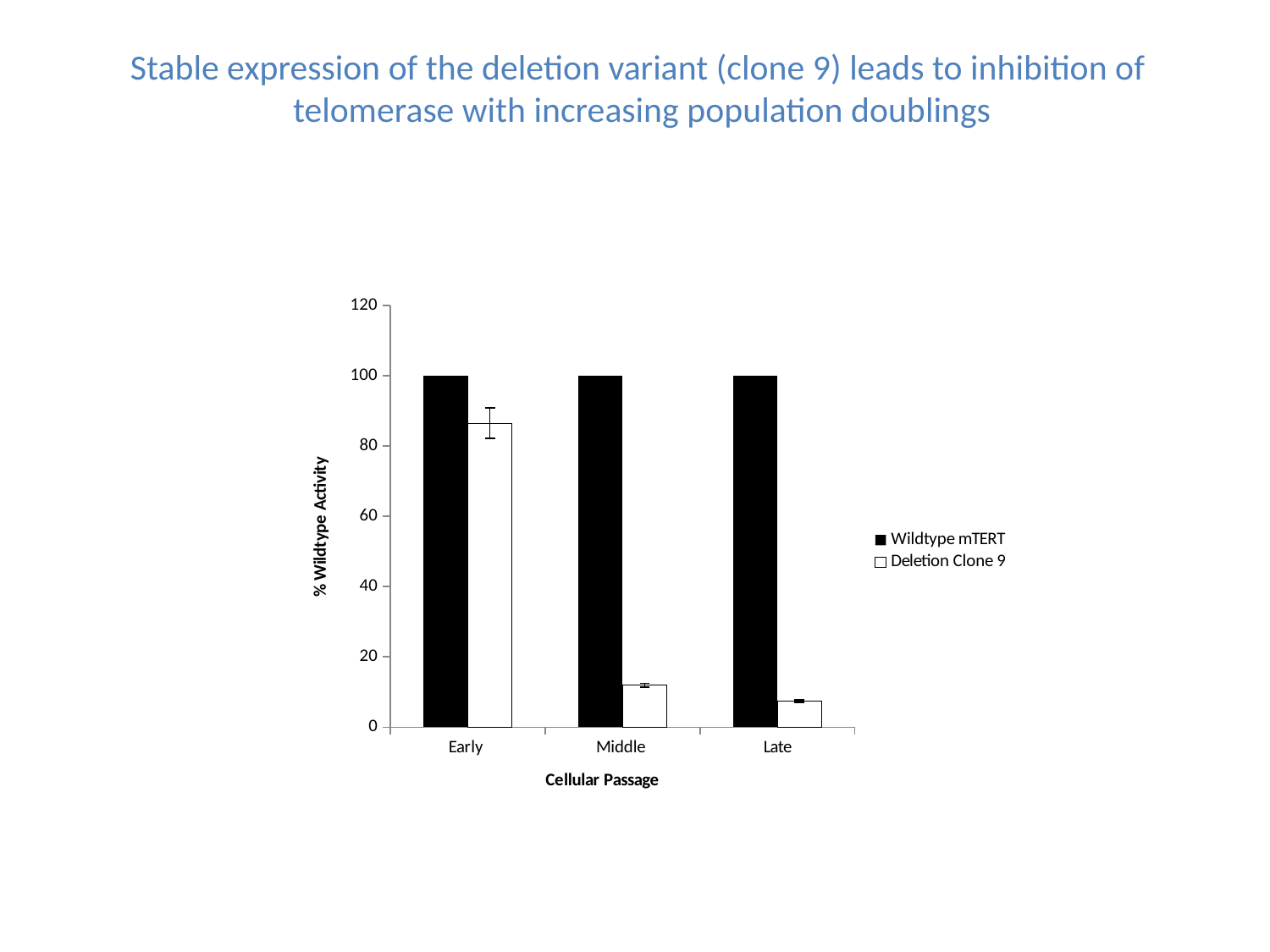
How many cellular passage categories are shown on the x axis? 3 For Deletion Clone 9, which passage has the larger value, Early or Middle? Early Is the value for Deletion Clone 9 at the Early passage greater or less than 80? greater What is the title of the x axis? Cellular Passage What kind of chart is shown on the slide? bar chart Do the Deletion Clone 9 values rise or fall from Early to Late passage? fall What is the % Wildtype Activity for Wildtype mTERT at the Early passage? 100 Is the value for Deletion Clone 9 at the Middle passage greater or less than 20? less How many series does the legend list? 2 Which passage has the highest value for Deletion Clone 9? Early Is the value for Deletion Clone 9 at the Late passage greater or less than 20? less Which passage has the lowest value for Deletion Clone 9? Late